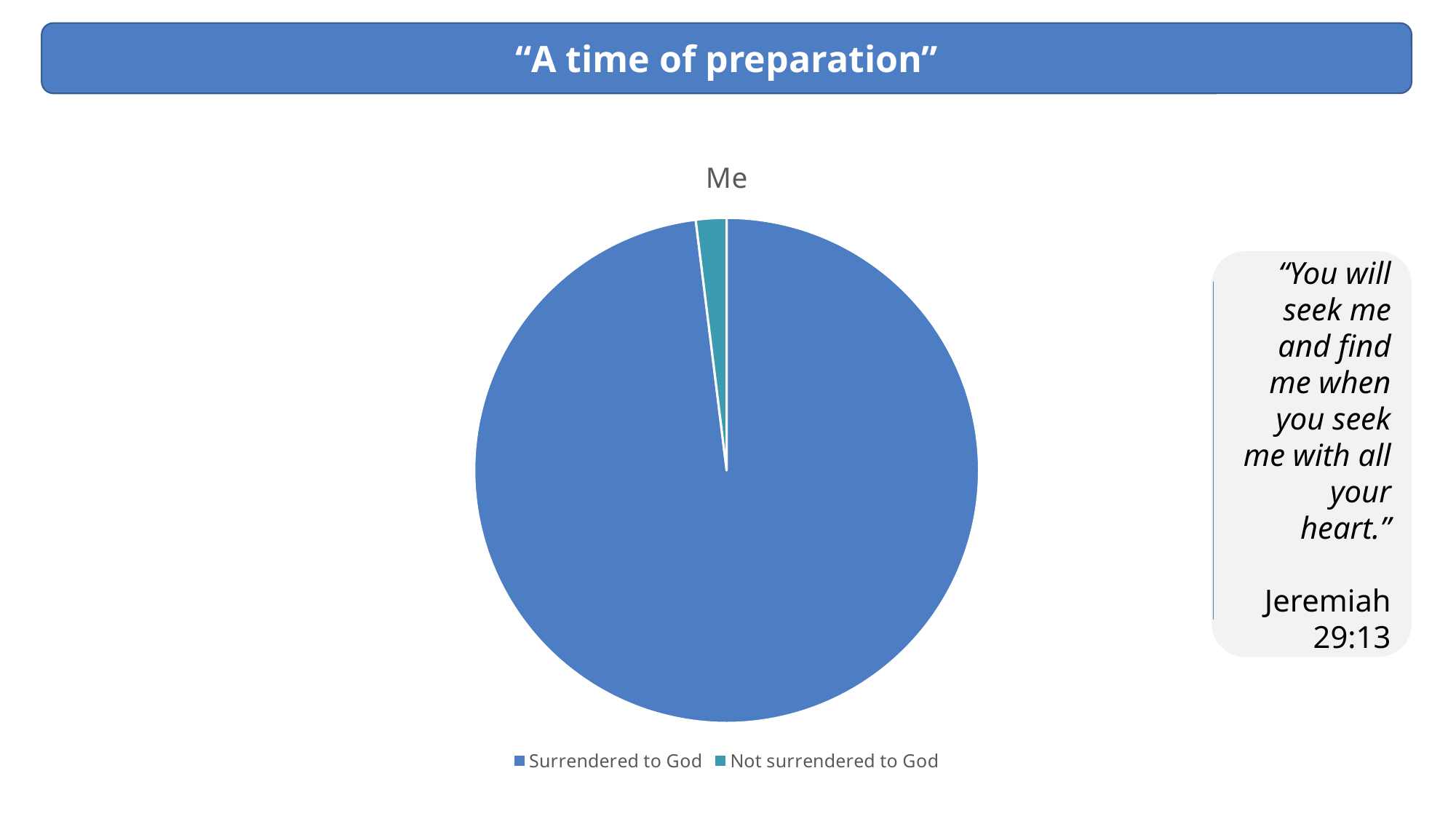
What is the title of the chart? Me What kind of chart is shown on the slide? pie chart Which is larger, the slice for Surrendered to God or the slice for Not surrendered to God? Surrendered to God Is the share of the pie for Surrendered to God greater or less than 50%? greater How many slices does the pie chart have? 2 How many entries does the legend list? 2 Which slice of the pie chart is the largest? Surrendered to God Is the share of the pie for Not surrendered to God greater or less than 10%? less Which slice of the pie chart is the smallest? Not surrendered to God What colour is the slice for Not surrendered to God? teal